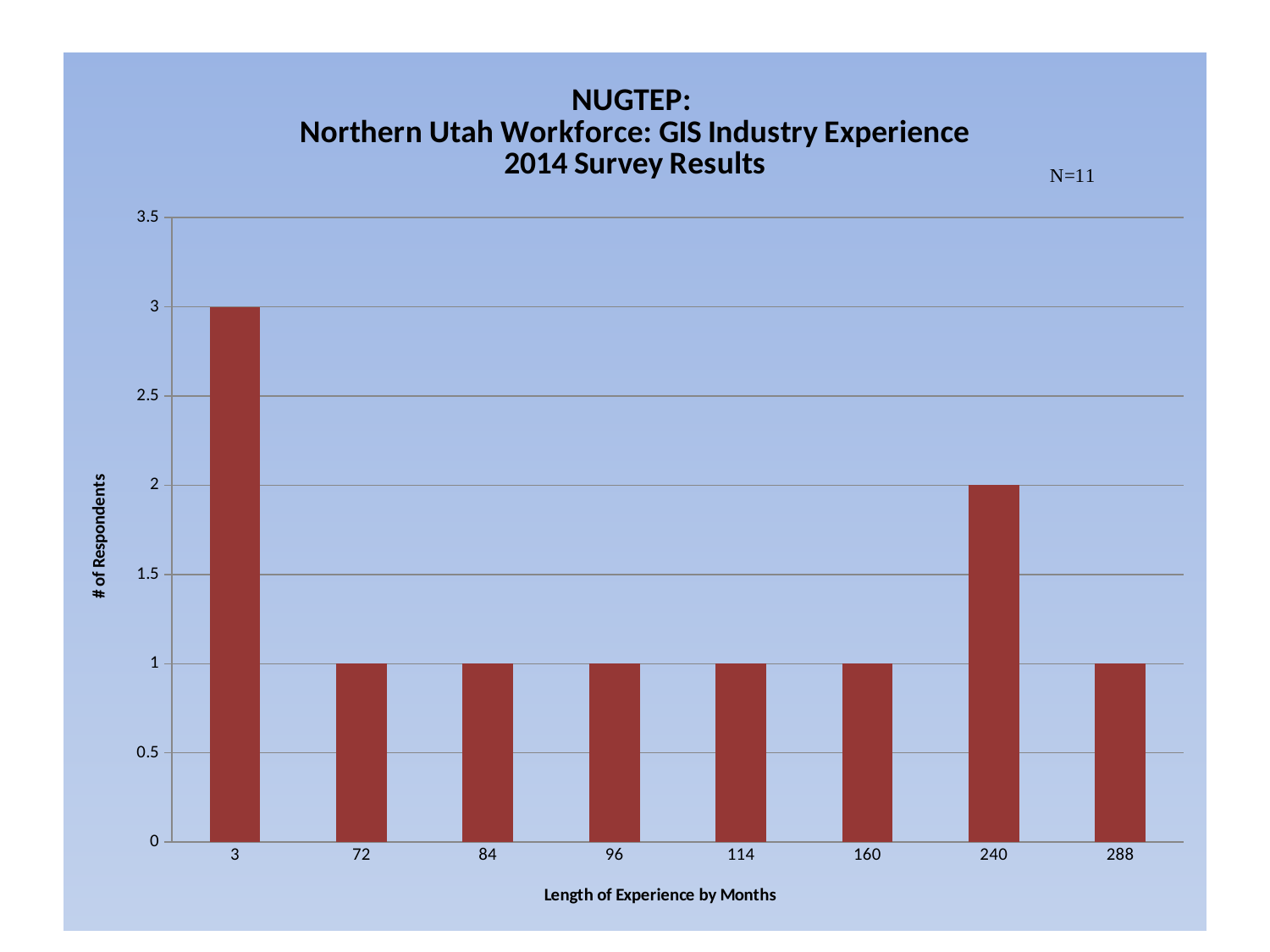
How many categories have exactly 1 respondent? 6 How many respondents reported 288 months of experience? 1 What is the label of the y axis? # of Respondents How many respondents reported 240 months of experience? 2 How many length-of-experience categories are shown on the x axis? 8 What sample size (N) is noted on the slide? N=11 What kind of chart is shown on the slide? bar chart Which has more respondents: 240 months or 160 months of experience? 240 Which length of experience has the highest number of respondents? 3 Is the number of respondents for 3 months of experience greater or less than 2.5? greater What is the difference in number of respondents between 3 months and 240 months of experience? 1 How many respondents reported 3 months of experience? 3